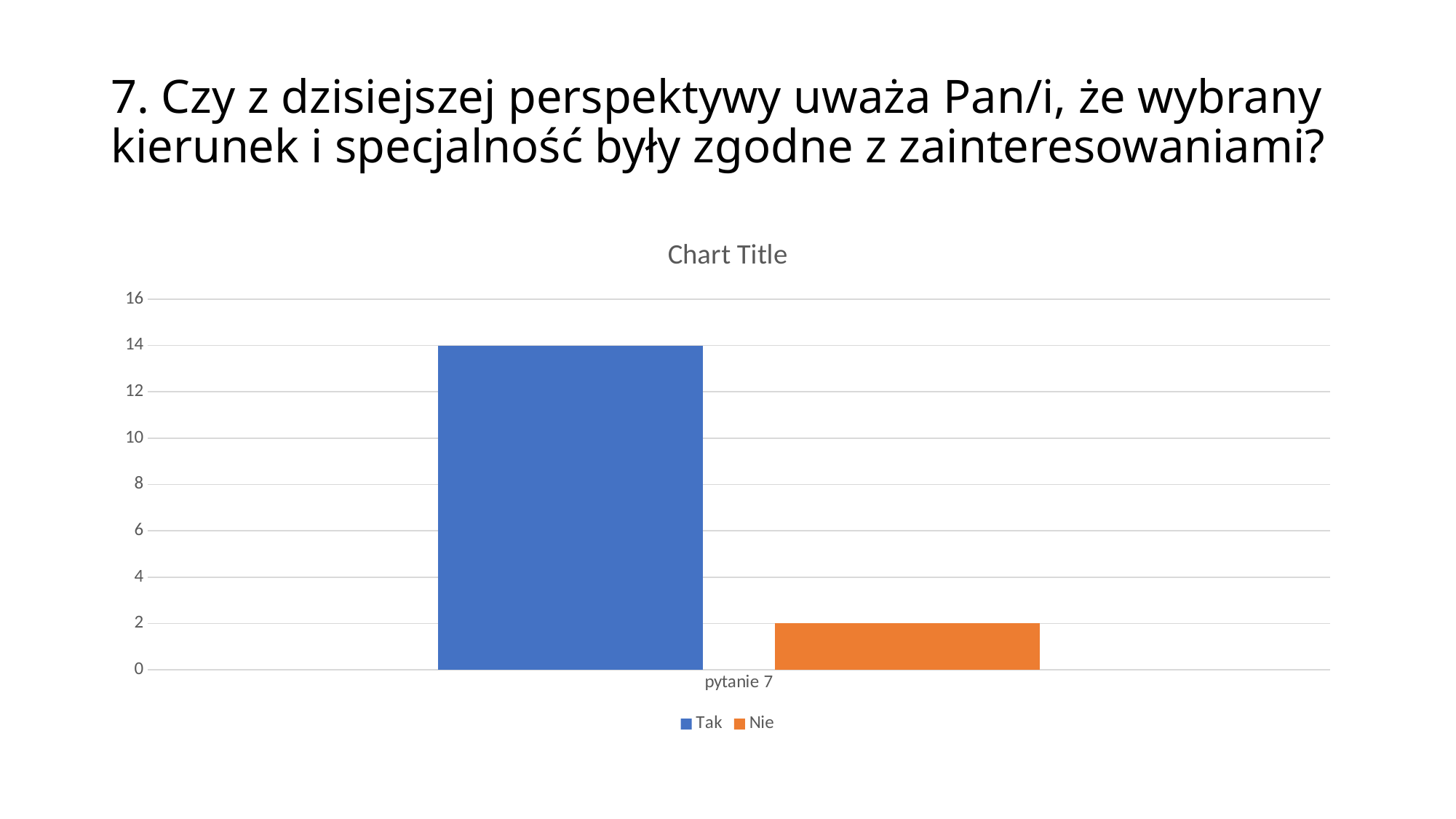
Is the value for Nie greater or less than 4? less Which series has the lowest value in the chart? Nie What kind of chart is shown on the slide? bar chart What is the difference between the values for Tak and Nie? 12 Which series has the highest value in the chart? Tak How many categories are shown on the x axis? 1 How many series does the legend list? 2 Which series has the higher value, Tak or Nie? Tak What is the value for Nie in the chart? 2 Is the value for Tak greater or less than 10? greater What is the value for Tak in the chart? 14 What is the label of the category on the x axis? pytanie 7